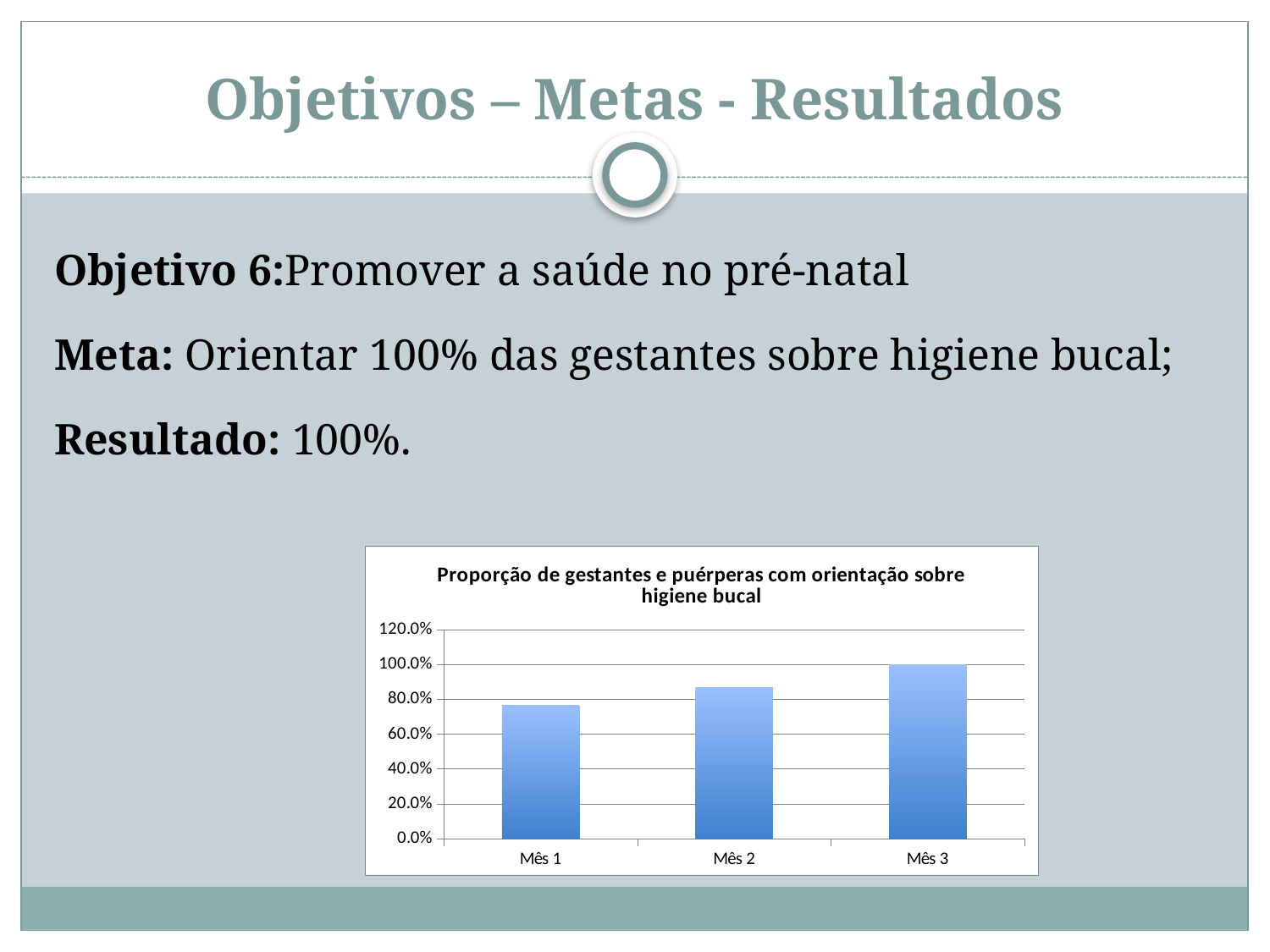
Is the value for Mês 1 greater or less than 80.0%? less Is the value for Mês 2 greater or less than 80.0%? greater What is the value for Mês 3 in the chart? 100.0% What is the title of the chart? Proporção de gestantes e puérperas com orientação sobre higiene bucal What kind of chart is shown on the slide? bar chart Which month has the lowest proportion in the chart? Mês 1 Is the value for Mês 2 greater or less than 100.0%? less What is the highest tick shown on the chart's vertical axis? 120.0% Which month has the highest proportion in the chart? Mês 3 Do the values rise or fall from Mês 1 to Mês 3? rise Which is larger, the value for Mês 1 or the value for Mês 2? Mês 2 How many categories (months) are plotted in the chart? 3